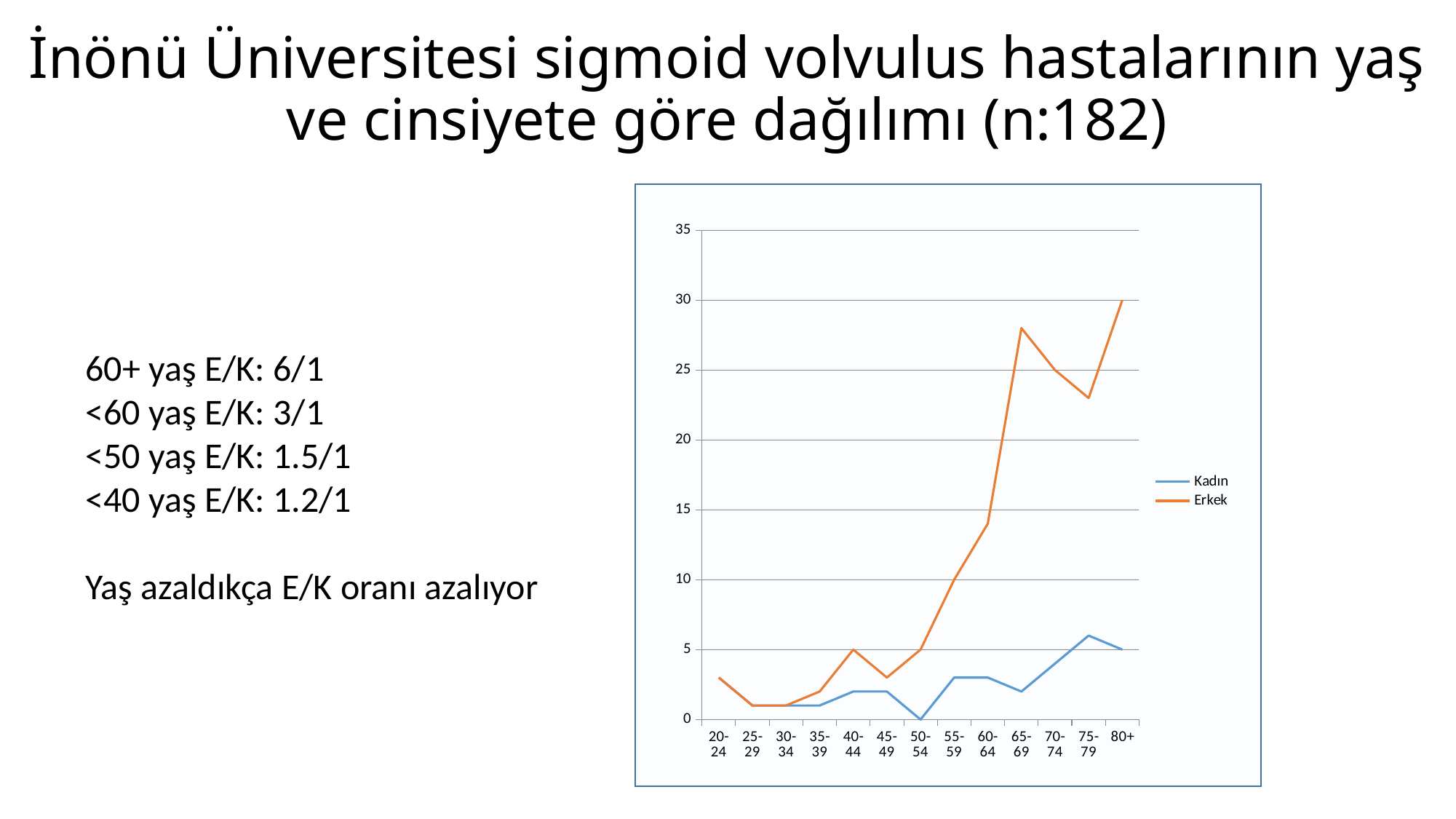
Is the value of the Erkek series for the 60-64 age group greater or less than 15? less How many series does the chart legend list? 2 Which colour is used for the Erkek line in the chart? orange What is the value of the Kadın series for the 50-54 age group? 0 How many age categories are shown on the x axis of the chart? 13 Is the value of the Erkek series for the 65-69 age group greater or less than 25? greater For the 80+ age group, which series has the larger value, Kadın or Erkek? Erkek What is the value of the Erkek series for the 80+ age group? 30 What is the value of the Erkek series for the 70-74 age group? 25 In which age group does the Kadın series reach its lowest value? 50-54 In which age group does the Erkek series reach its highest value? 80+ What kind of chart is shown on the slide? line chart